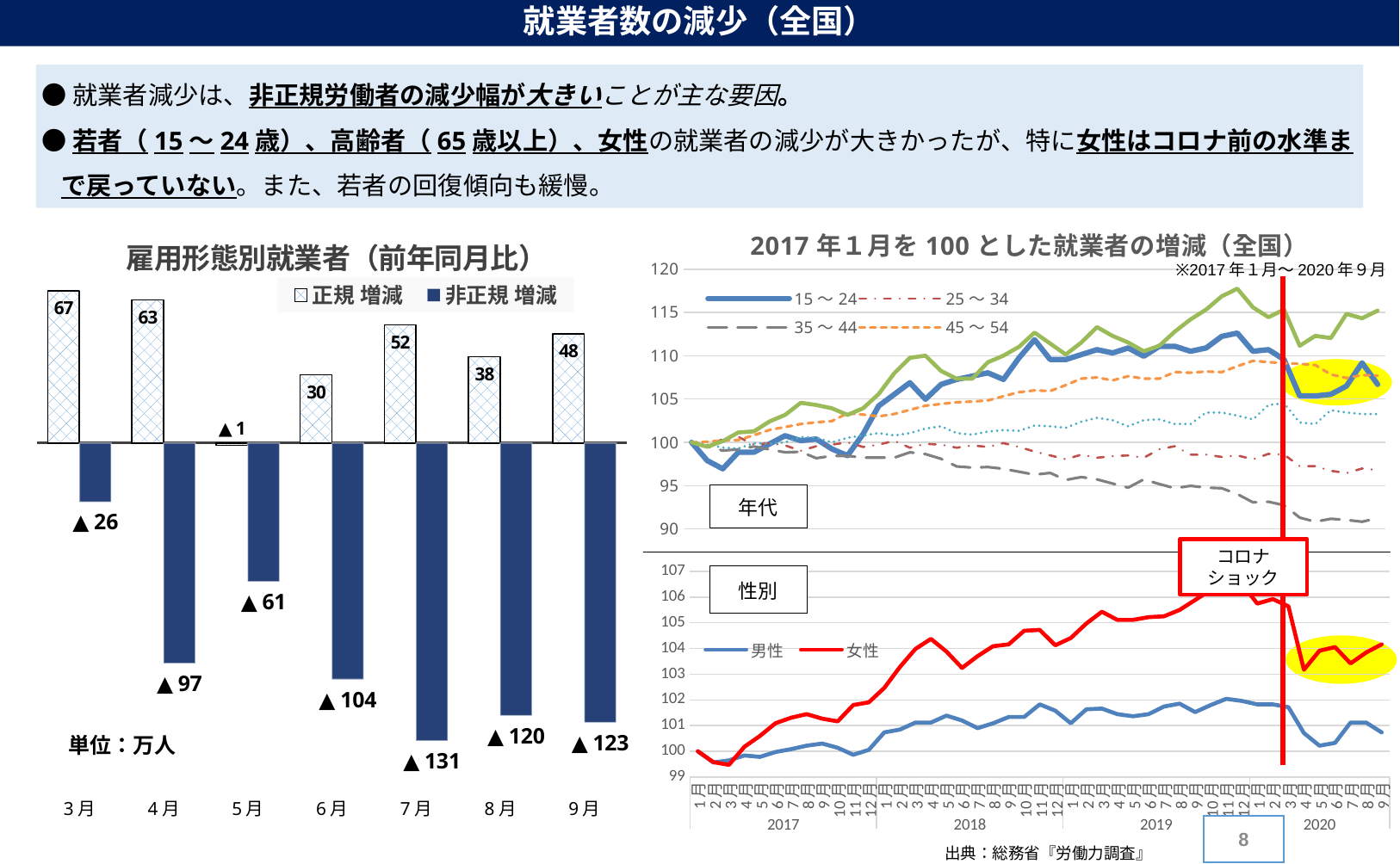
In the bar chart 雇用形態別就業者（前年同月比）, what is the value of 正規 増減 for 3月? 67 In the bar chart 雇用形態別就業者（前年同月比）, what is the value of 非正規 増減 for 9月? ▲123 How many months are shown on the x axis of the bar chart 雇用形態別就業者（前年同月比）? 7 In the bar chart 雇用形態別就業者（前年同月比）, which month has the largest decrease in 非正規 増減? 7月 In the bar chart 雇用形態別就業者（前年同月比）, which month has the highest 正規 増減 value? 3月 In the bar chart 雇用形態別就業者（前年同月比）, what is the value of 非正規 増減 for 7月? ▲131 In the bar chart 雇用形態別就業者（前年同月比）, what is the difference between the 正規 増減 values for 3月 and 4月? 4 In the bar chart 雇用形態別就業者（前年同月比）, is the 正規 増減 value larger for 7月 or 8月? 7月 How many series does the legend of the bar chart 雇用形態別就業者（前年同月比） list? 2 In the bar chart 雇用形態別就業者（前年同月比）, what is the value of 正規 増減 for 5月? ▲1 What type of chart is the 性別 chart at the bottom right of the slide? Line chart In the 性別 line chart at the bottom right, which series is drawn in red? 女性